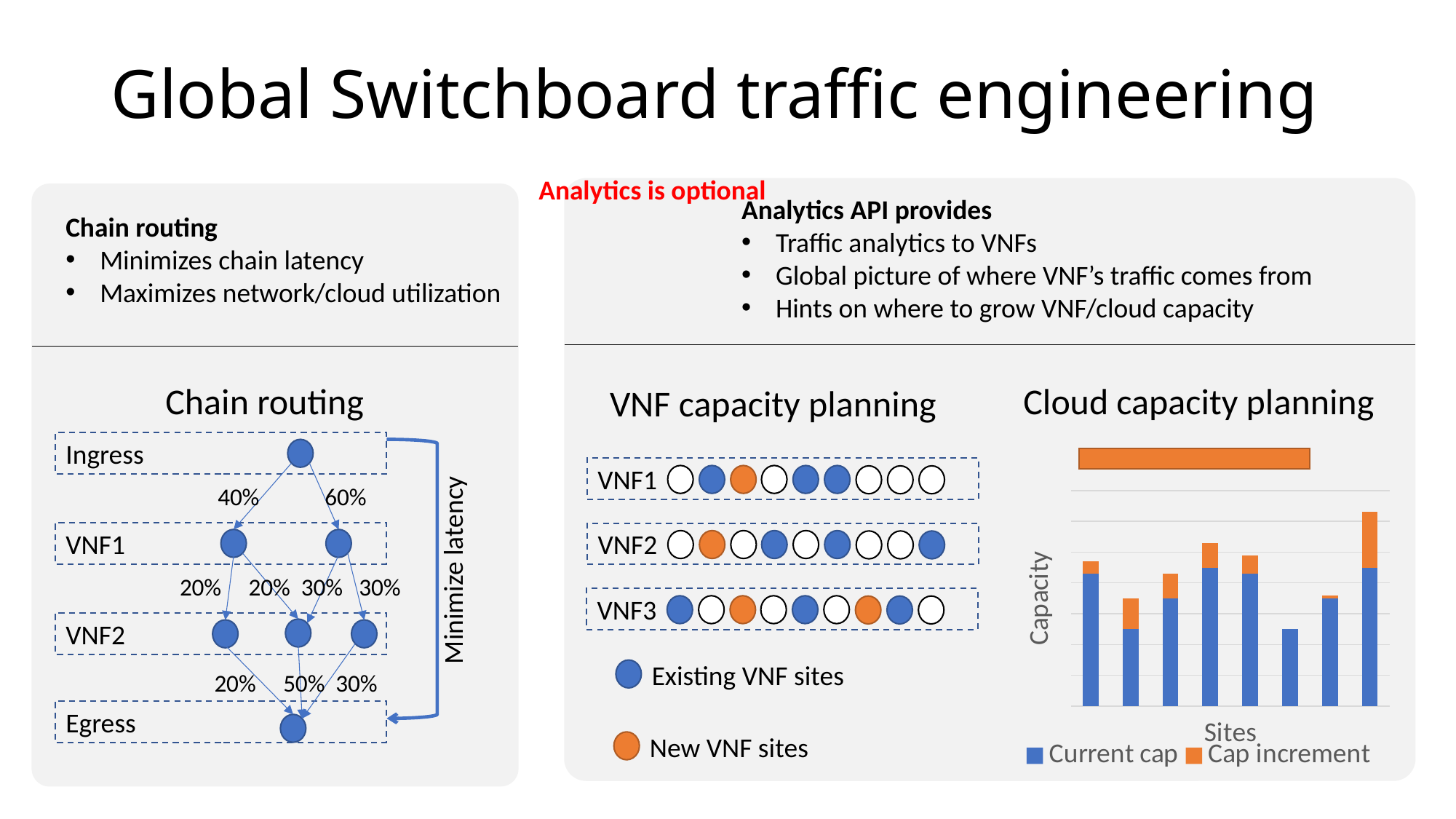
In the Cloud capacity planning chart, which colour represents Cap increment? orange What is the title of the vertical axis in the Cloud capacity planning chart? Capacity How many series does the legend of the Cloud capacity planning chart list? 2 In the Cloud capacity planning chart, which bar has the lowest Current cap? the second and sixth bars from the left (tied) What kind of chart is the Cloud capacity planning chart? bar chart In the Cloud capacity planning chart, which bar reaches the greatest total height? the rightmost bar In the Cloud capacity planning chart, which bar has the largest Cap increment segment? the rightmost bar What are the two legend entries in the Cloud capacity planning chart? Current cap, Cap increment How many bars (sites) are plotted in the Cloud capacity planning chart? 8 In the Cloud capacity planning chart, is the Current cap of the rightmost bar larger or smaller than that of the sixth bar from the left? larger